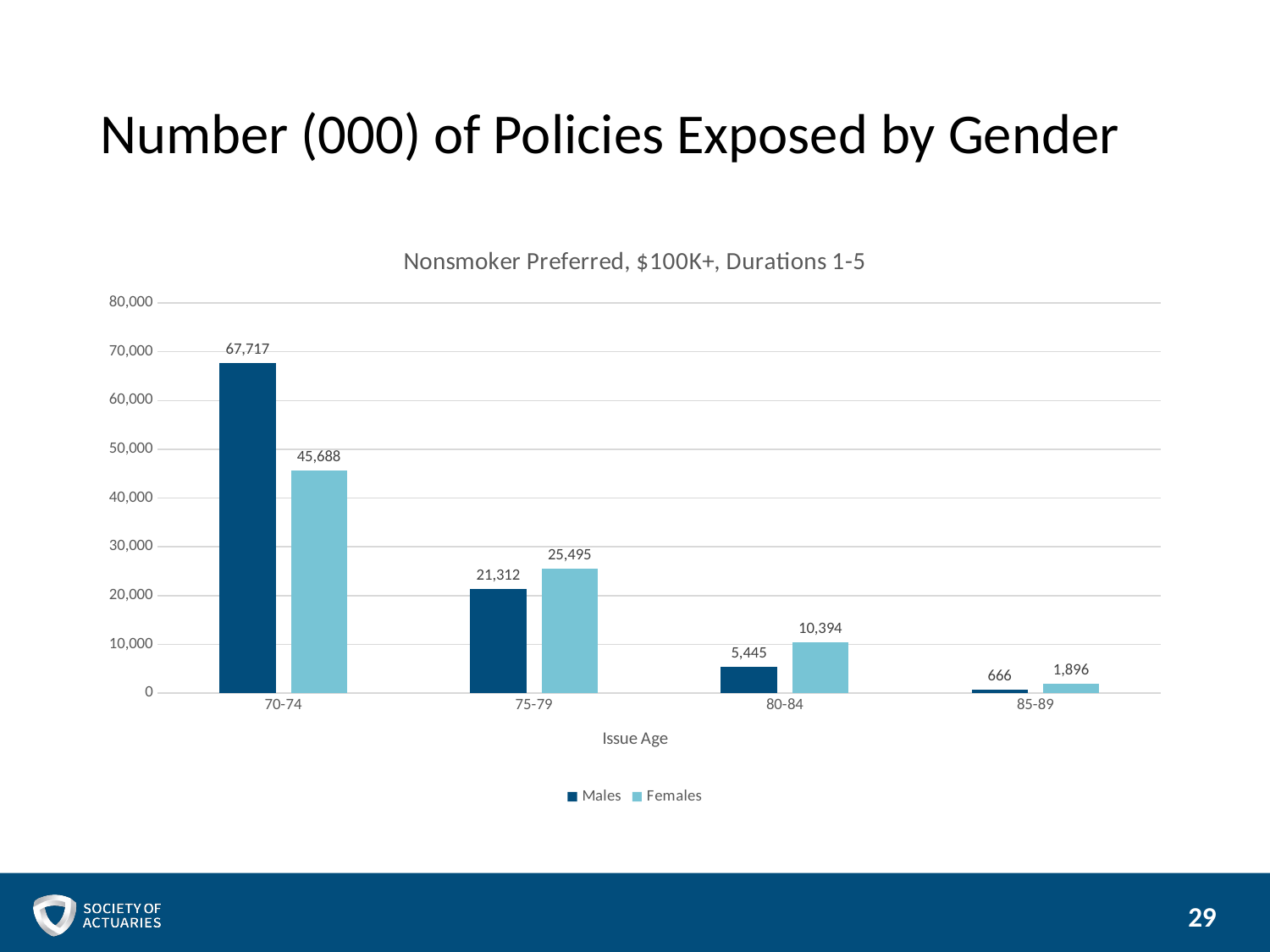
What is the difference between the Females and Males values in the 75-79 issue age group? 4,183 What is the value for Females in the 80-84 issue age group? 10,394 Which issue age group has the highest value for Females? 70-74 Which issue age group has the lowest value for Males? 85-89 What is the value for Males in the 70-74 issue age group? 67,717 Is the value for Females in the 75-79 issue age group greater or less than 20,000? greater In the 80-84 issue age group, which is larger, Males or Females? Females How many issue age groups are shown on the x axis? 4 What is the difference between the Males and Females values in the 70-74 issue age group? 22,029 What is the value for Males in the 85-89 issue age group? 666 How many series does the legend list? 2 What kind of chart is shown on the slide? Bar chart